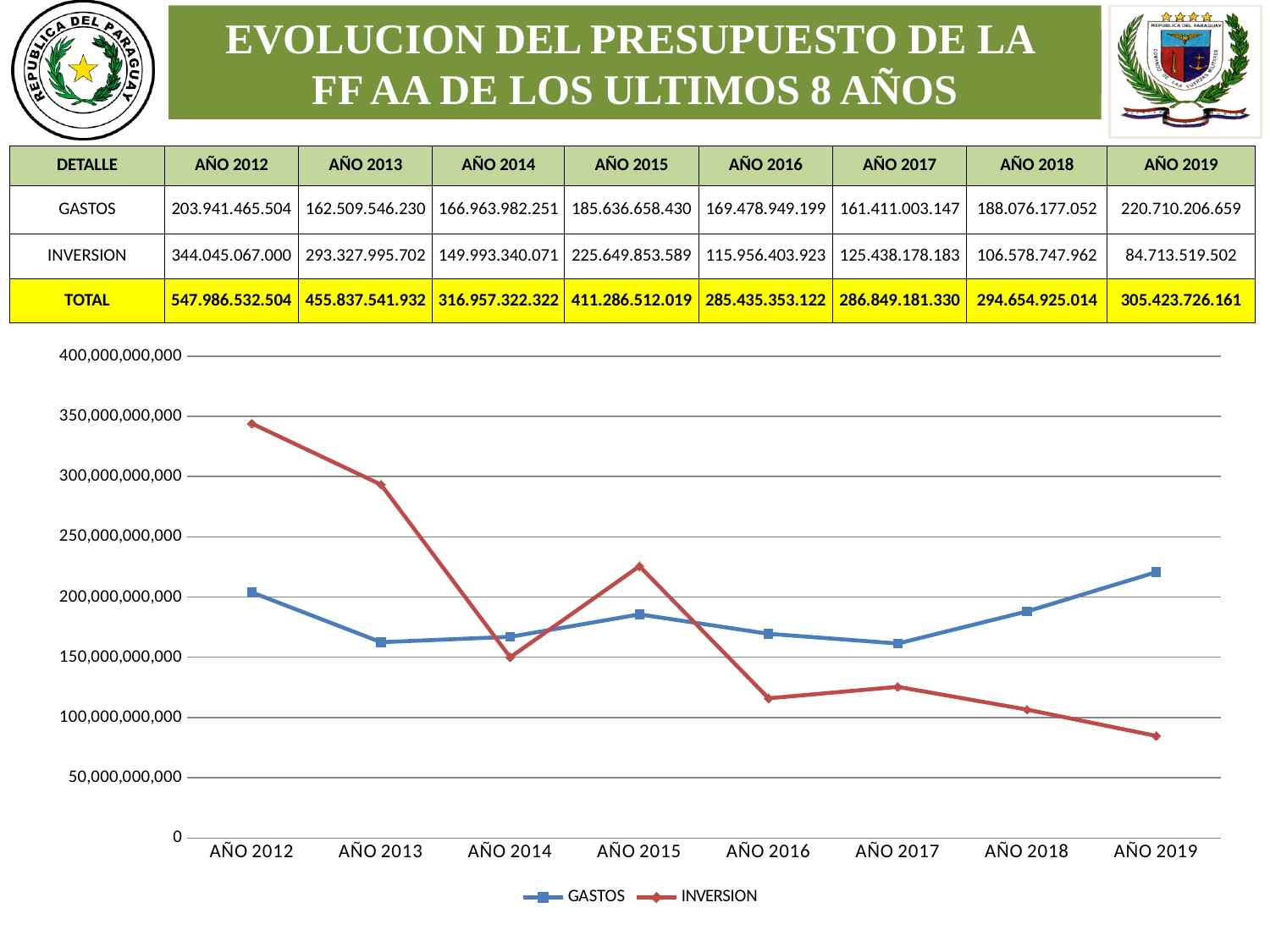
In AÑO 2015, which series has the larger value, GASTOS or INVERSION? INVERSION What kind of chart is shown on the slide? line chart What is the INVERSION value for AÑO 2014? 149.993.340.071 In which year is the INVERSION series lowest? AÑO 2019 In which year is the GASTOS series highest? AÑO 2019 In which year is the INVERSION series highest? AÑO 2012 What is the TOTAL for AÑO 2012? 547.986.532.504 What is the GASTOS value for AÑO 2019? 220.710.206.659 How many series does the chart legend list? 2 What is the difference between GASTOS in AÑO 2019 and GASTOS in AÑO 2012? 16.768.741.155 Is the INVERSION value for AÑO 2016 greater or less than 150,000,000,000? less How many years are plotted on the x axis of the chart? 8